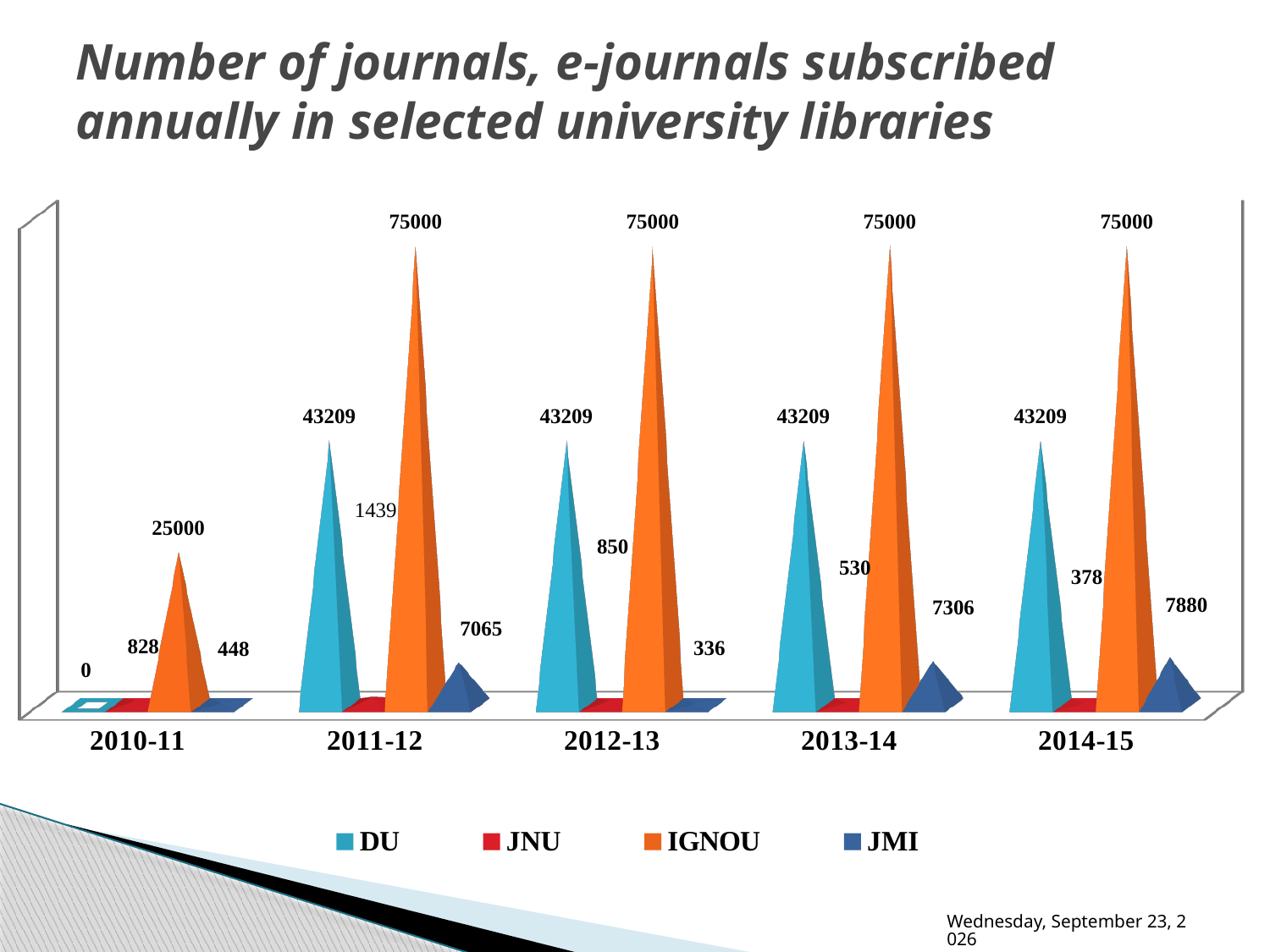
What is the value for IGNOU in 2010-11? 25000 Which is larger in 2013-14, the JNU value or the JMI value? JMI How many year categories are shown on the x axis? 5 How many series does the legend list? 4 Which series has the highest value in 2013-14? IGNOU What is the value for DU in 2010-11? 0 What is the value for JMI in 2014-15? 7880 Which series has the lowest value in 2012-13? JMI Does the JNU value rise or fall from 2011-12 to 2014-15? fall What kind of chart is shown on the slide? bar chart What is the value for JNU in 2011-12? 1439 What is the difference between the IGNOU and DU values in 2014-15? 31791